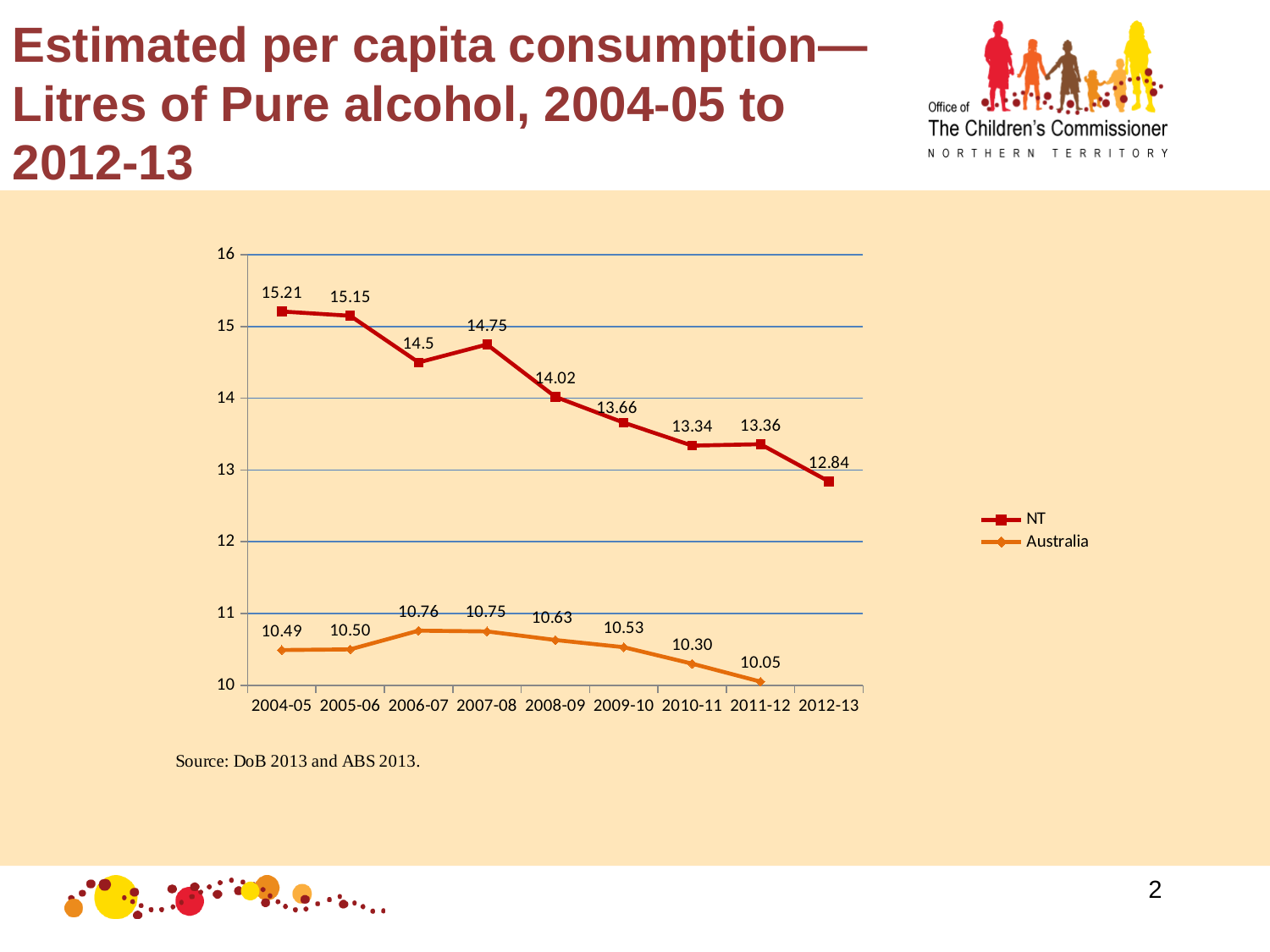
What type of chart is shown on the slide? Line chart In which year is the NT value highest? 2004-05 What is the difference between the NT and Australia values in 2008-09? 3.39 What is the Australia value for 2011-12? 10.05 Does the NT series generally rise or fall from 2004-05 to 2012-13? Fall How many series does the legend list? 2 What is the Australia value for 2006-07? 10.76 What is the NT value for 2012-13? 12.84 What is the NT value for 2004-05? 15.21 In which year is the Australia value lowest? 2011-12 How many years are shown on the x axis? 9 Which is larger, the NT value for 2010-11 or the NT value for 2011-12? 2011-12